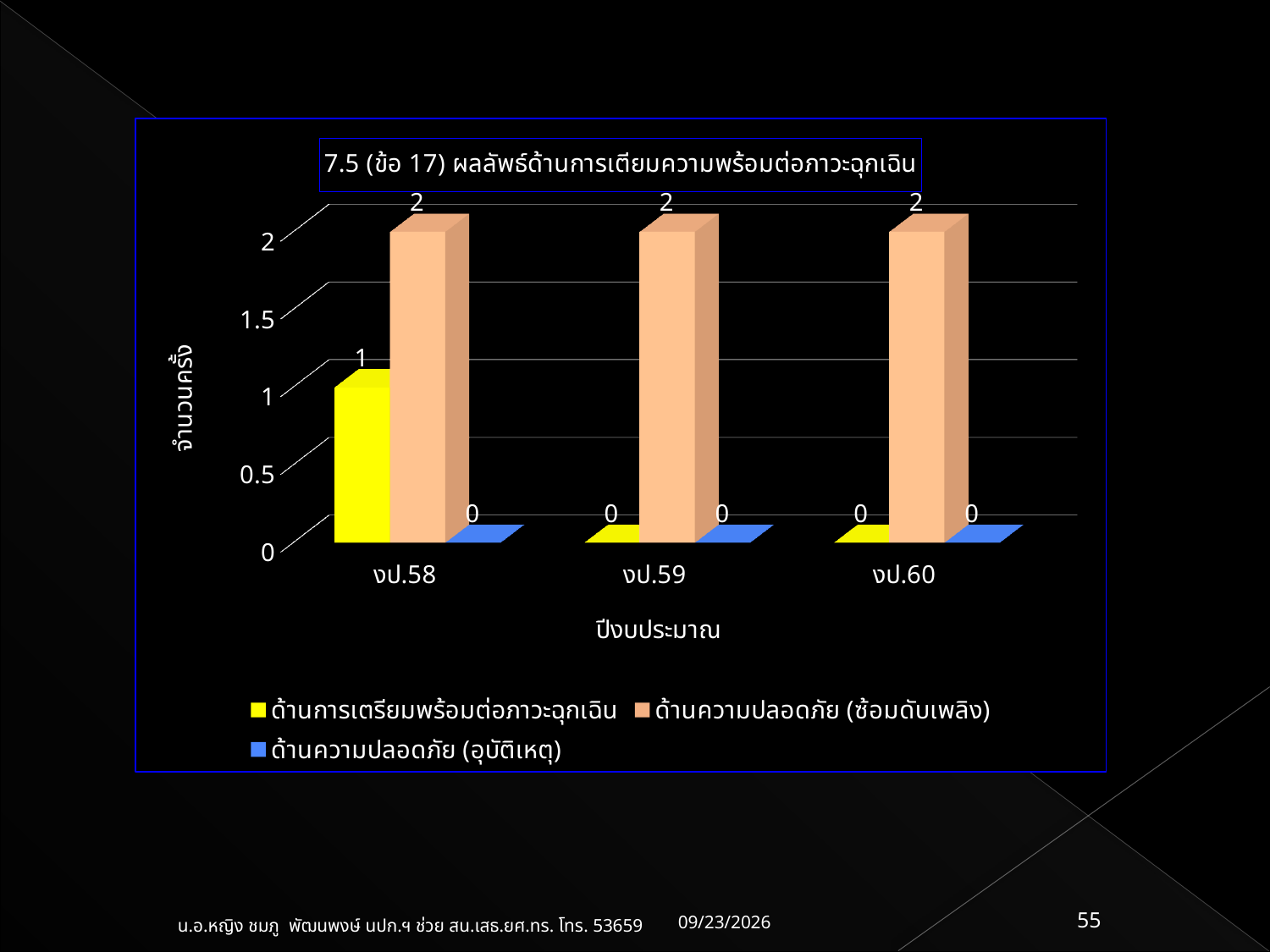
What is the value of ด้านความปลอดภัย (ซ้อมดับเพลิง) for งป.59? 2 How many series does the legend list? 3 Which is larger for งป.59: ด้านความปลอดภัย (ซ้อมดับเพลิง) or ด้านการเตรียมพร้อมต่อภาวะฉุกเฉิน? ด้านความปลอดภัย (ซ้อมดับเพลิง) What is the label of the y axis of the chart? จำนวนครั้ง What type of chart is shown on the slide? bar chart Which series has the highest value for งป.58? ด้านความปลอดภัย (ซ้อมดับเพลิง) What is the difference between ด้านความปลอดภัย (ซ้อมดับเพลิง) and ด้านการเตรียมพร้อมต่อภาวะฉุกเฉิน for งป.58? 1 What is the value of ด้านการเตรียมพร้อมต่อภาวะฉุกเฉิน for งป.60? 0 Does the value of ด้านการเตรียมพร้อมต่อภาวะฉุกเฉิน rise, fall, or stay the same from งป.58 to งป.59? fall What is the value of ด้านการเตรียมพร้อมต่อภาวะฉุกเฉิน for งป.58? 1 How many categories are shown on the x axis of the chart? 3 What is the value of ด้านความปลอดภัย (อุบัติเหตุ) for งป.60? 0